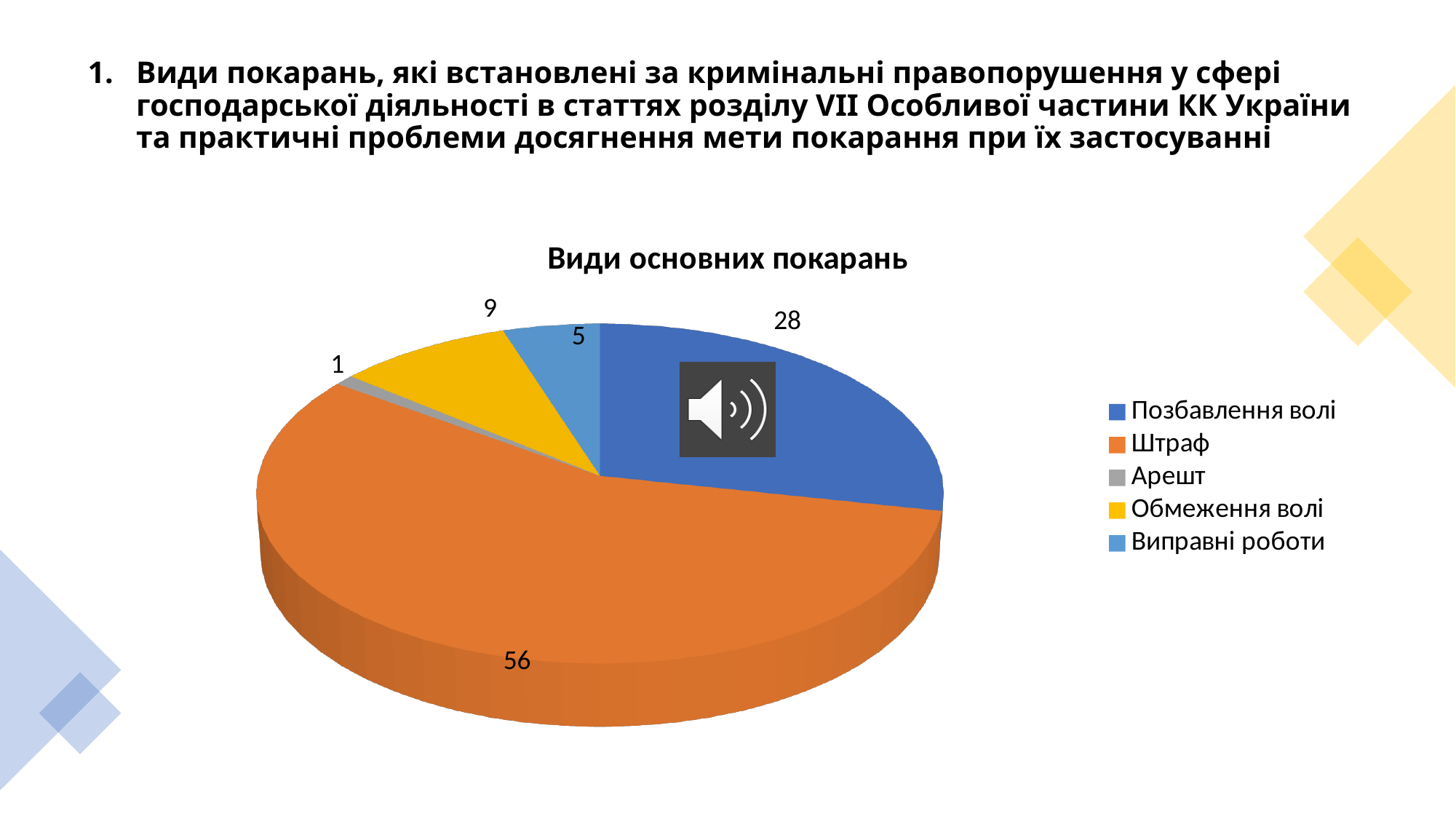
Which category has the smallest slice in the pie chart? Арешт What kind of chart is shown on the slide? Pie chart What is the difference between the values for Штраф and Позбавлення волі? 28 What is the value for Виправні роботи in the pie chart? 5 What is the value for Позбавлення волі in the pie chart? 28 Which is larger, the value for Обмеження волі or the value for Виправні роботи? Обмеження волі What is the value for Арешт in the pie chart? 1 What is the title of the chart? Види основних покарань How many categories does the pie chart show? 5 Which category has the largest slice in the pie chart? Штраф What is the value for Обмеження волі in the pie chart? 9 What is the value for Штраф in the pie chart? 56